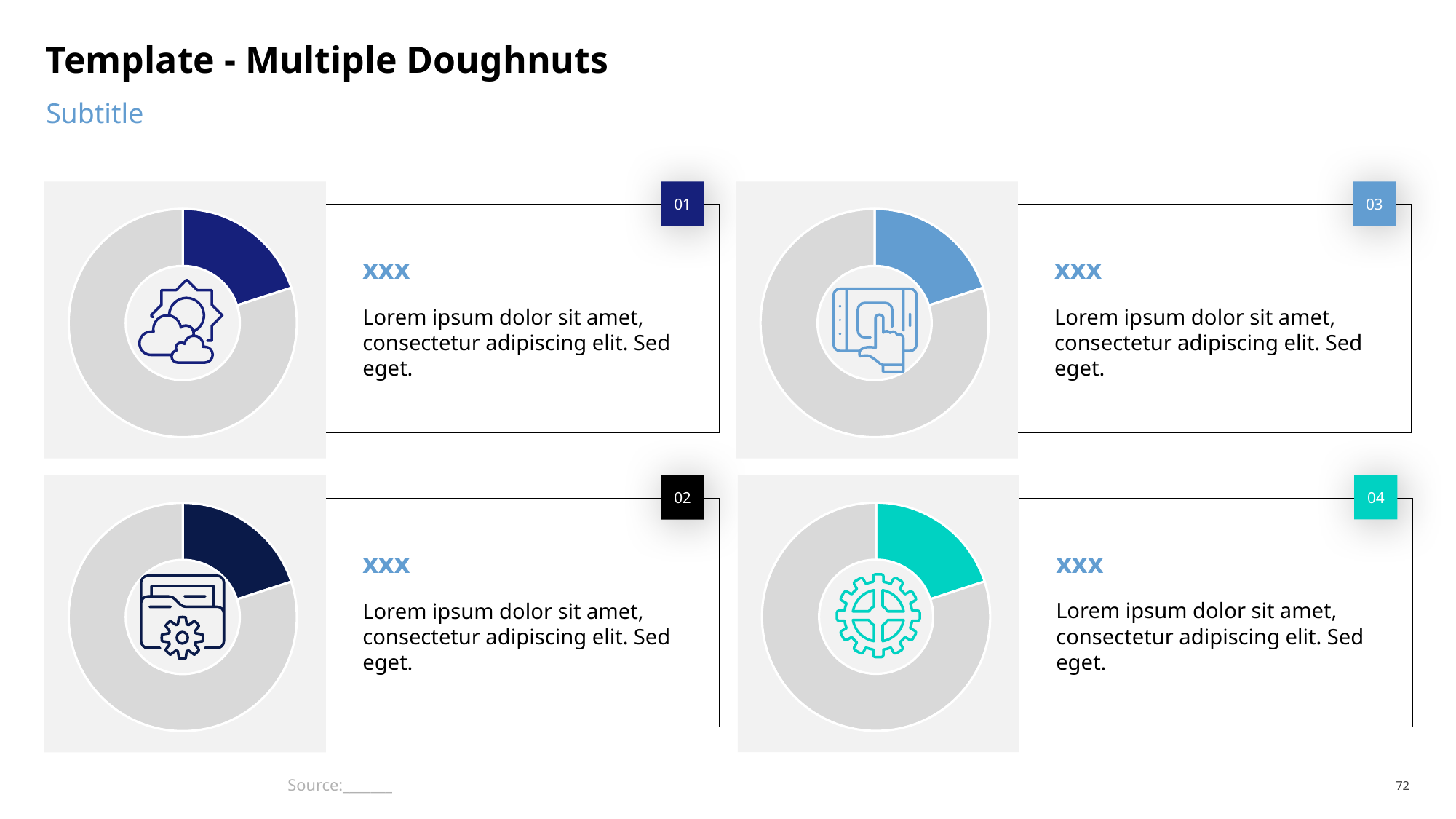
In the doughnut chart in panel 01, which segment is larger, the coloured segment or the grey segment? the grey segment What kind of chart is used in each of the four panels on the slide? doughnut chart In the doughnut chart in panel 03, which segment is smaller, the coloured segment or the grey segment? the coloured segment In the doughnut chart in panel 04, which segment is larger, the coloured segment or the grey segment? the grey segment How many segments does the doughnut chart in panel 01 have? 2 How many doughnut charts are on the slide? 4 What colour is the highlighted segment of the doughnut chart in panel 03? light blue What colour is the highlighted segment of the doughnut chart in panel 04? teal